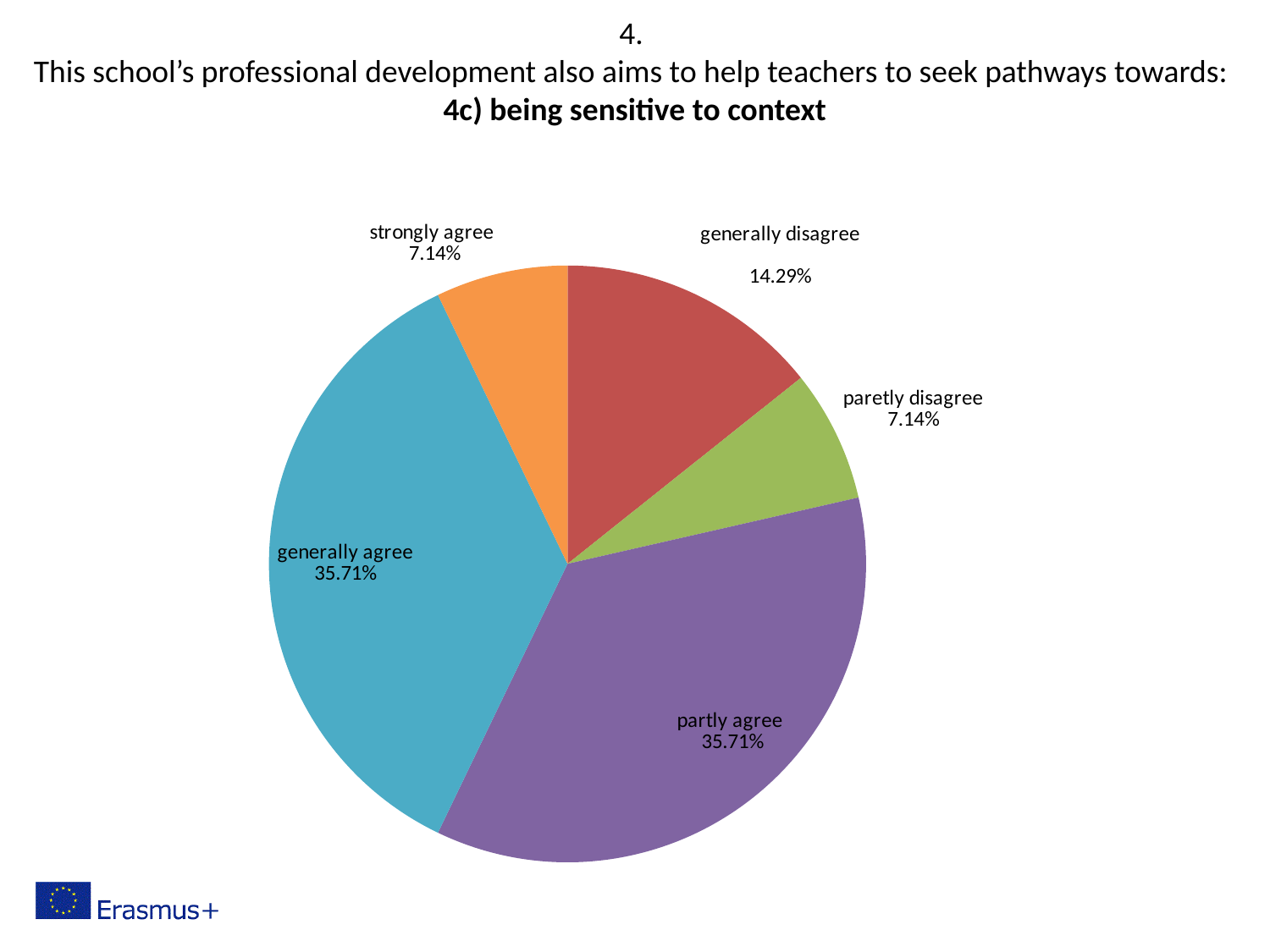
What share of the pie is labelled 'generally disagree'? 14.29% What is the difference between the 'generally disagree' share and the 'paretly disagree' share? 7.15% What kind of chart is shown on the slide? pie chart What colour is the 'partly agree' slice? purple What share of the pie is labelled 'partly agree'? 35.71% What share of the pie is labelled 'strongly agree'? 7.14% What is the bold subtitle of the chart on the slide? 4c) being sensitive to context What share of the pie is labelled 'paretly disagree'? 7.14% What is the difference between the 'generally agree' share and the 'generally disagree' share? 21.42% Which is larger, the 'generally disagree' slice or the 'strongly agree' slice? generally disagree Which two categories share the largest percentage in the pie chart? generally agree and partly agree How many slices does the pie chart have? 5